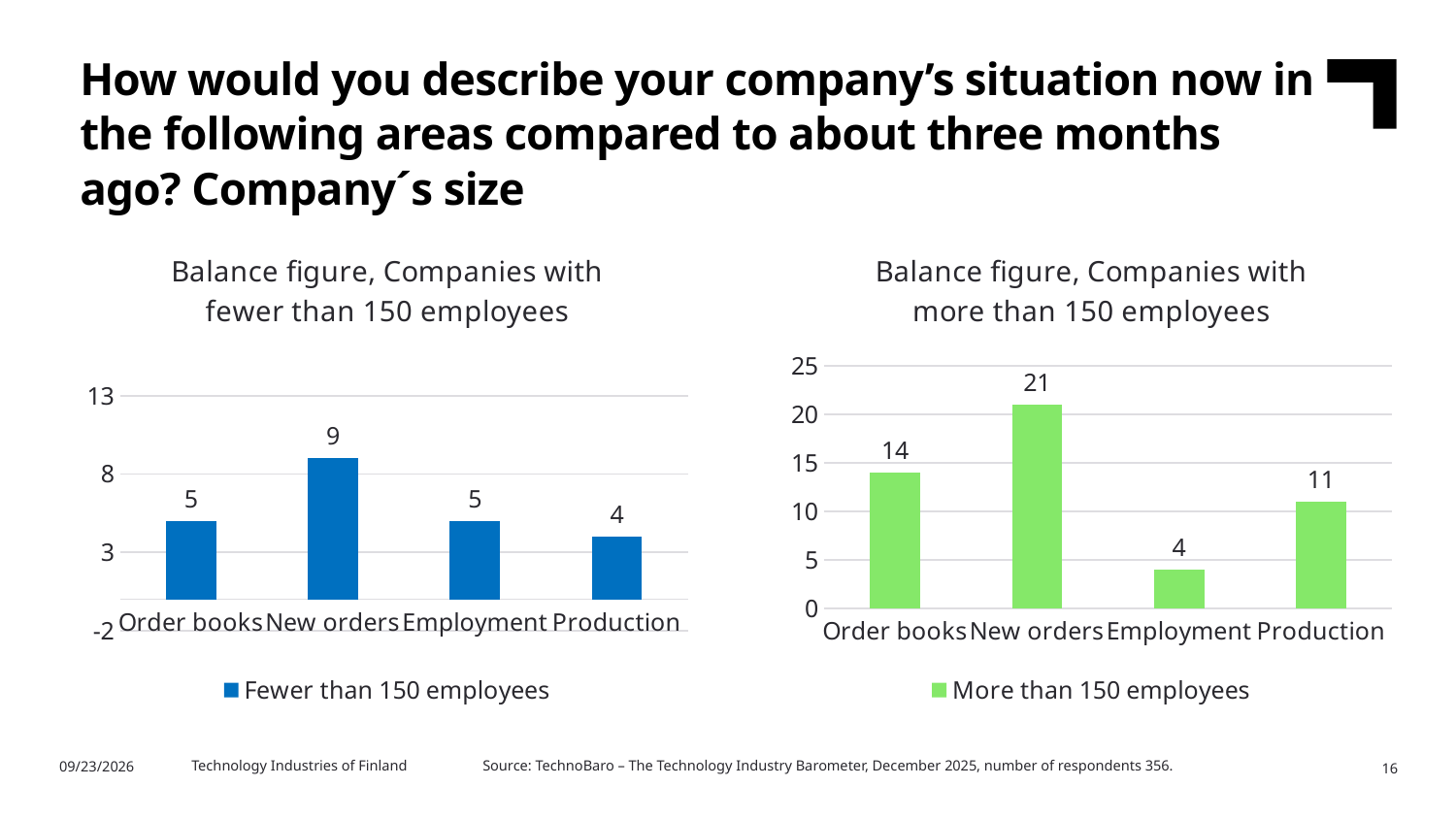
In the chart titled 'Balance figure, Companies with fewer than 150 employees', what is the value for New orders? 9 In the chart titled 'Balance figure, Companies with more than 150 employees', which category has the highest value? New orders How many categories are shown in the chart titled 'Balance figure, Companies with fewer than 150 employees'? 4 In the chart titled 'Balance figure, Companies with more than 150 employees', which category has the lowest value? Employment What kind of chart is the chart titled 'Balance figure, Companies with more than 150 employees'? Bar chart What legend entry is shown under the chart titled 'Balance figure, Companies with fewer than 150 employees'? Fewer than 150 employees In the chart titled 'Balance figure, Companies with fewer than 150 employees', which category has the lowest value? Production In the chart titled 'Balance figure, Companies with fewer than 150 employees', what is the difference between the values for New orders and Production? 5 In the chart titled 'Balance figure, Companies with more than 150 employees', what is the difference between the values for New orders and Employment? 17 In the chart titled 'Balance figure, Companies with more than 150 employees', what is the value for Order books? 14 In the chart titled 'Balance figure, Companies with more than 150 employees', which is larger, the value for Order books or the value for Production? Order books In the chart titled 'Balance figure, Companies with more than 150 employees', is the value for New orders greater or less than 20? greater